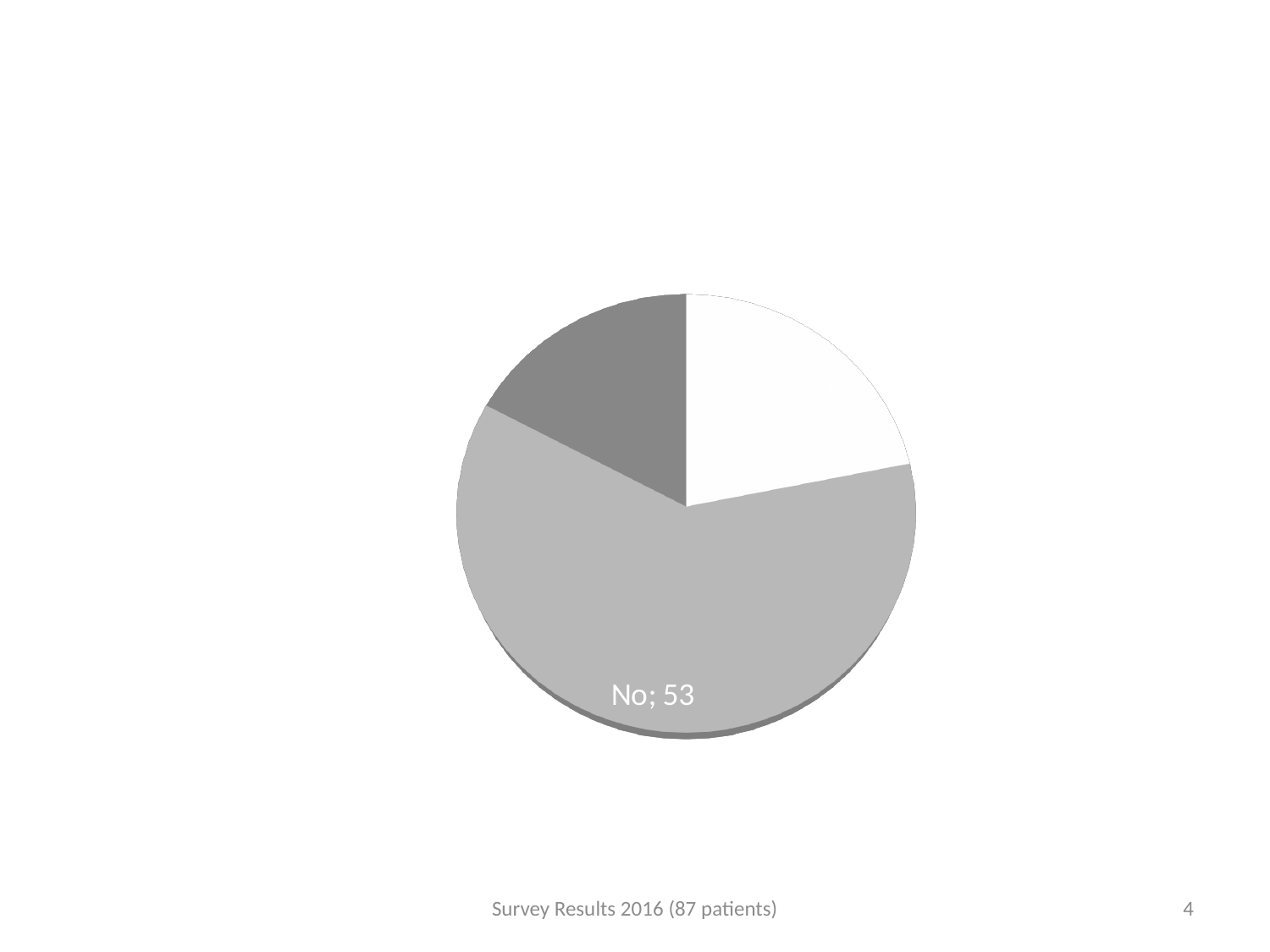
What value is shown for the slice labelled No? 53 What kind of chart is shown on the slide? pie chart What text appears in the footer below the chart? Survey Results 2016 (87 patients) Which slice of the pie chart is the largest? No Does the slice labelled No take up more or less than half of the pie? more How many slices does the pie chart have? 3 What colour is the slice labelled No? light grey